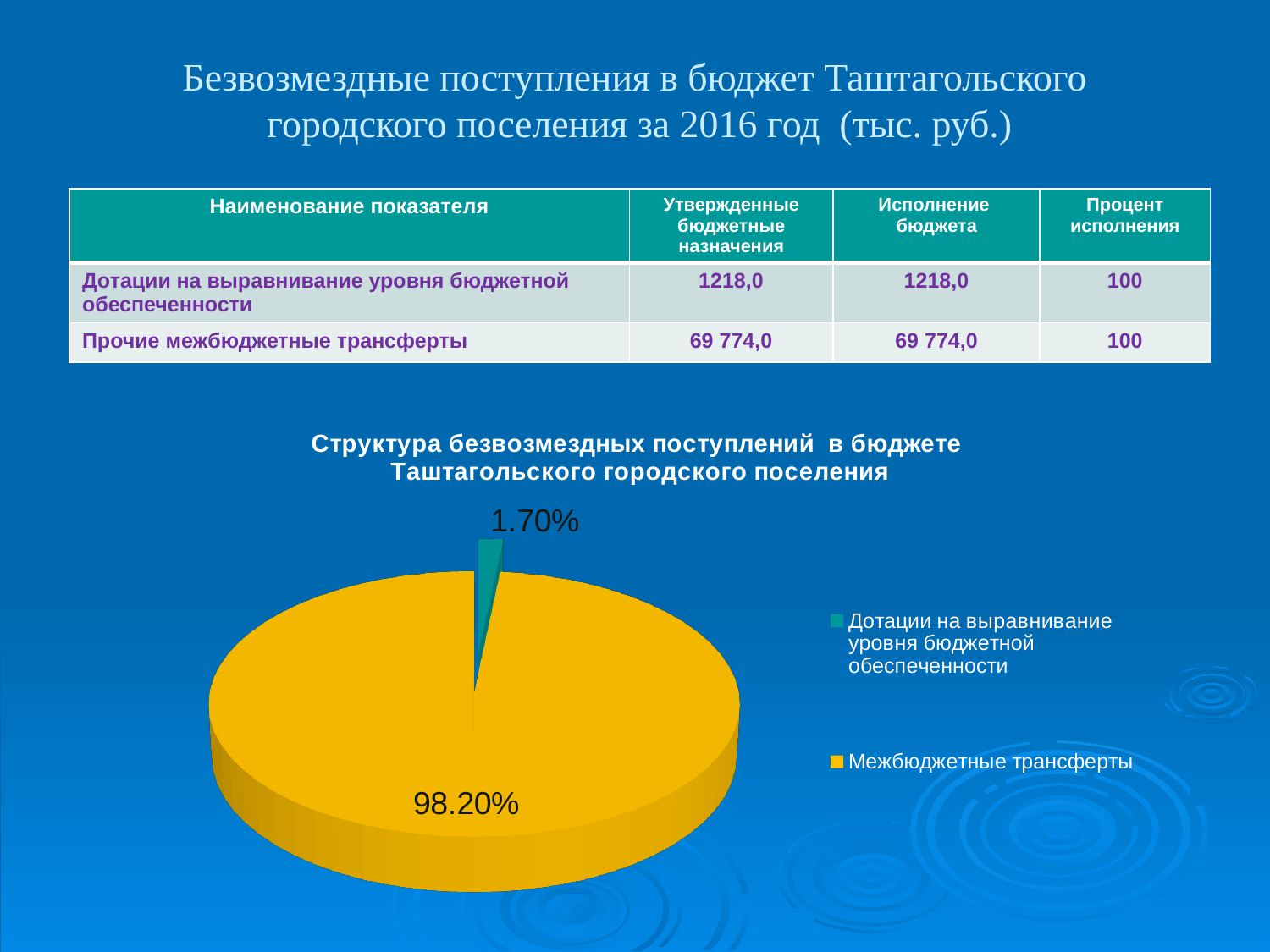
How many slices does the pie chart have? 2 What is the title of the pie chart? Структура безвозмездных поступлений в бюджете Таштагольского городского поселения What share of the pie does "Межбюджетные трансферты" have? 98.20% What share of the pie does "Дотации на выравнивание уровня бюджетной обеспеченности" have? 1.70% Which slice of the pie chart is the smallest? Дотации на выравнивание уровня бюджетной обеспеченности How many entries does the legend of the pie chart list? 2 Which is larger in the pie chart: "Межбюджетные трансферты" or "Дотации на выравнивание уровня бюджетной обеспеченности"? Межбюджетные трансферты What colour is the "Межбюджетные трансферты" slice in the pie chart? Yellow Which slice of the pie chart is the largest? Межбюджетные трансферты What is the difference in percentage points between the "Межбюджетные трансферты" slice and the "Дотации на выравнивание уровня бюджетной обеспеченности" slice? 96.50 What kind of chart is shown on the slide? Pie chart